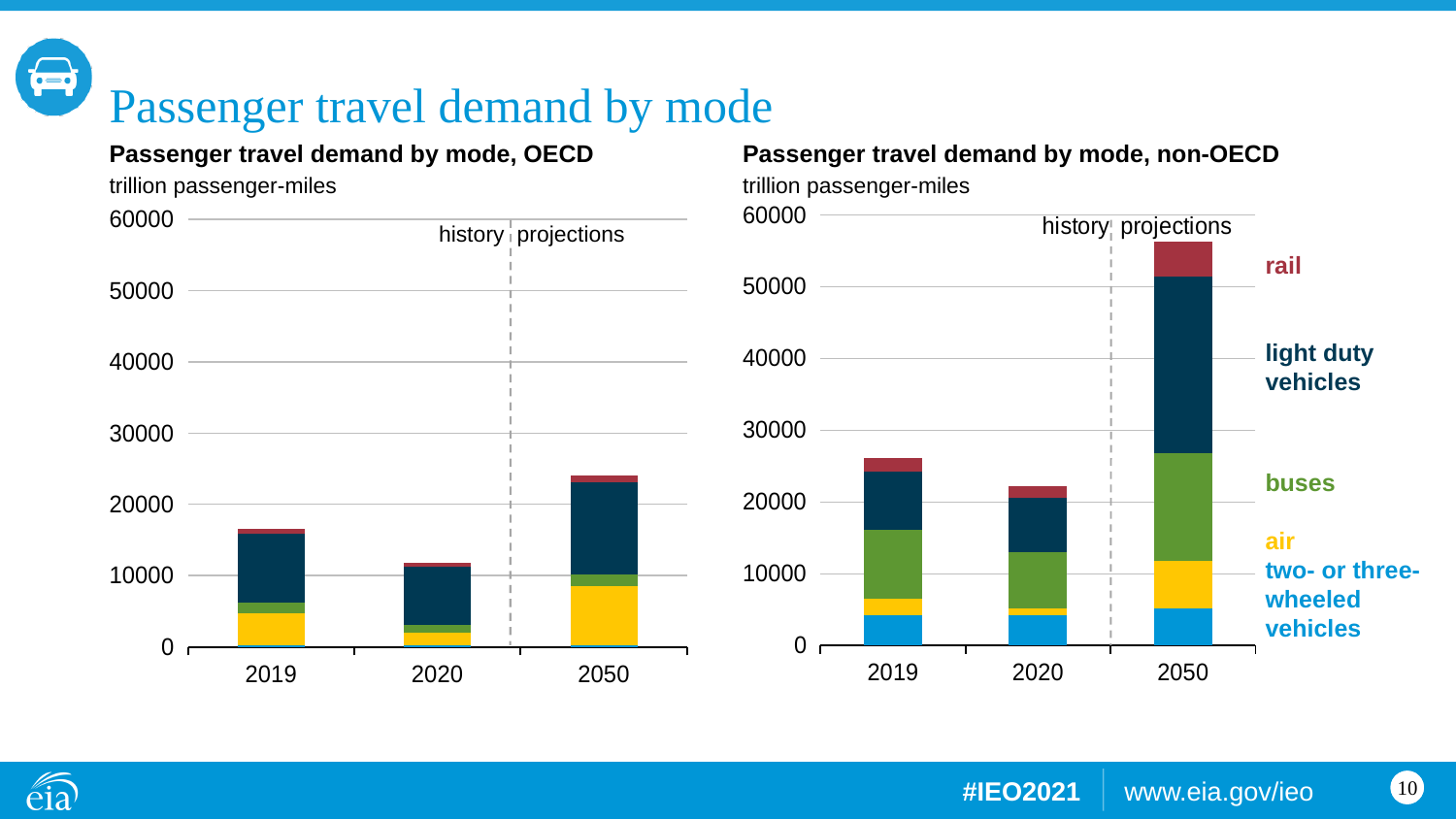
In the 'Passenger travel demand by mode, OECD' chart, which year has the tallest total bar? 2050 In the 'Passenger travel demand by mode, non-OECD' chart, is the total bar for 2019 greater or less than 20000? greater Which chart has the taller total bar for 2050, the OECD chart or the non-OECD chart? non-OECD In the 'Passenger travel demand by mode, OECD' chart, which year has the shortest total bar? 2020 In the 'Passenger travel demand by mode, non-OECD' chart, how many modes are labelled beside the bars? 5 In the 'Passenger travel demand by mode, non-OECD' chart, is the total bar for 2050 greater or less than 50000? greater What kind of chart is the 'Passenger travel demand by mode, OECD' chart? stacked bar chart In the 'Passenger travel demand by mode, non-OECD' chart, which mode is shown by the dark navy segment? light duty vehicles In the 'Passenger travel demand by mode, OECD' chart, is the total bar for 2050 greater or less than 30000? less What unit is given under the title of the 'Passenger travel demand by mode, OECD' chart? trillion passenger-miles In the 'Passenger travel demand by mode, non-OECD' chart, which year has the tallest total bar? 2050 In the 'Passenger travel demand by mode, OECD' chart, how many years are shown on the x axis? 3